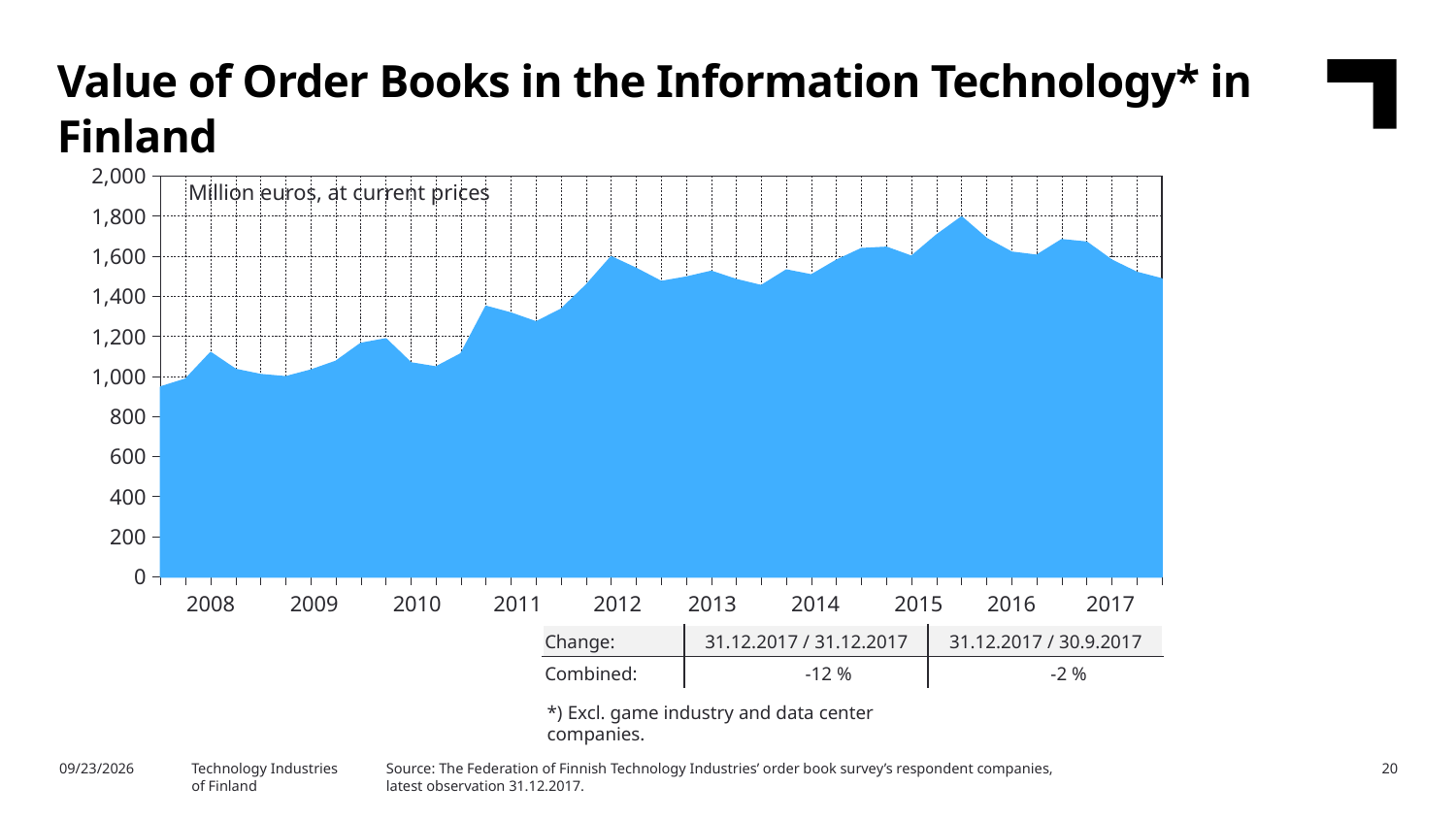
What is the highest value shown on the y axis of the chart? 2,000 Overall, do the order book values rise or fall from 2008 to 2017? Rise What kind of chart is shown on the slide? Area chart What is the title of the chart? Value of Order Books in the Information Technology* in Finland Is the value of the order books at the start of 2008 greater or less than 1,200? less Is the peak value of the order books, reached around 2015–2016, greater or less than 1,600? greater Is the value of the order books in mid-2010 greater or less than 1,200? less According to the table below the chart, what is the combined change from 31.12.2017 / 30.9.2017? -2 % In what unit are the values on the chart expressed, according to the label inside the plot area? Million euros, at current prices According to the table below the chart, what is the combined change from 31.12.2017 / 31.12.2017? -12 % How many years are labeled on the x axis of the chart? 10